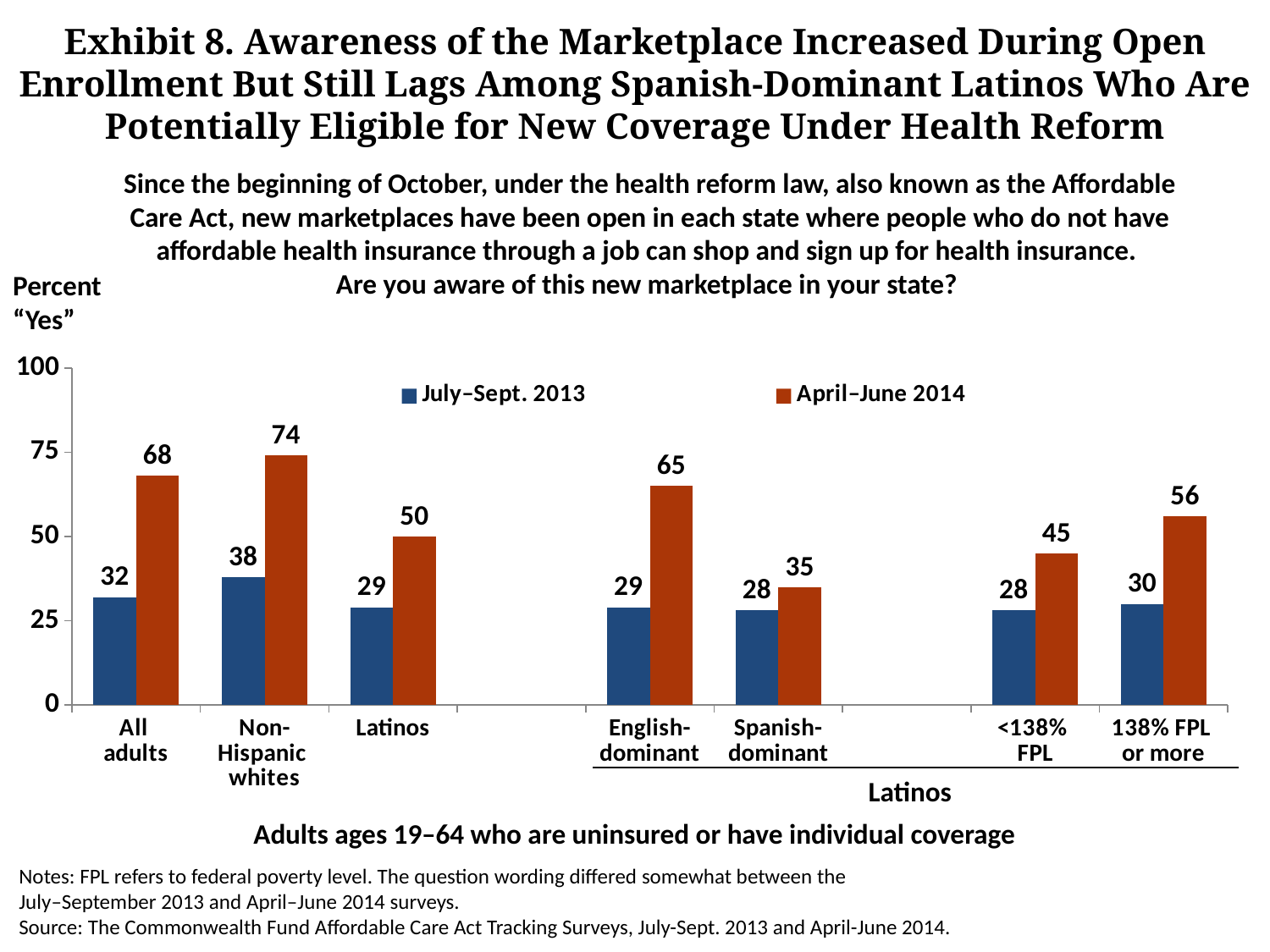
Which category has the highest April–June 2014 value? Non-Hispanic whites What kind of chart is shown on the slide? Bar chart Which category has the lowest April–June 2014 value? Spanish-dominant What is the April–June 2014 value for Latinos with 138% FPL or more? 56 Which is larger: the April–June 2014 value for Latinos or for <138% FPL? Latinos How many series does the legend list? 2 How many categories are shown on the x axis? 7 What is the July–Sept. 2013 value for Spanish-dominant Latinos? 28 What is the difference between the April–June 2014 values for English-dominant and Spanish-dominant Latinos? 30 What is the April–June 2014 value for Non-Hispanic whites? 74 Which series is shown in orange-red bars? April–June 2014 What is the difference between the April–June 2014 and July–Sept. 2013 values for All adults? 36